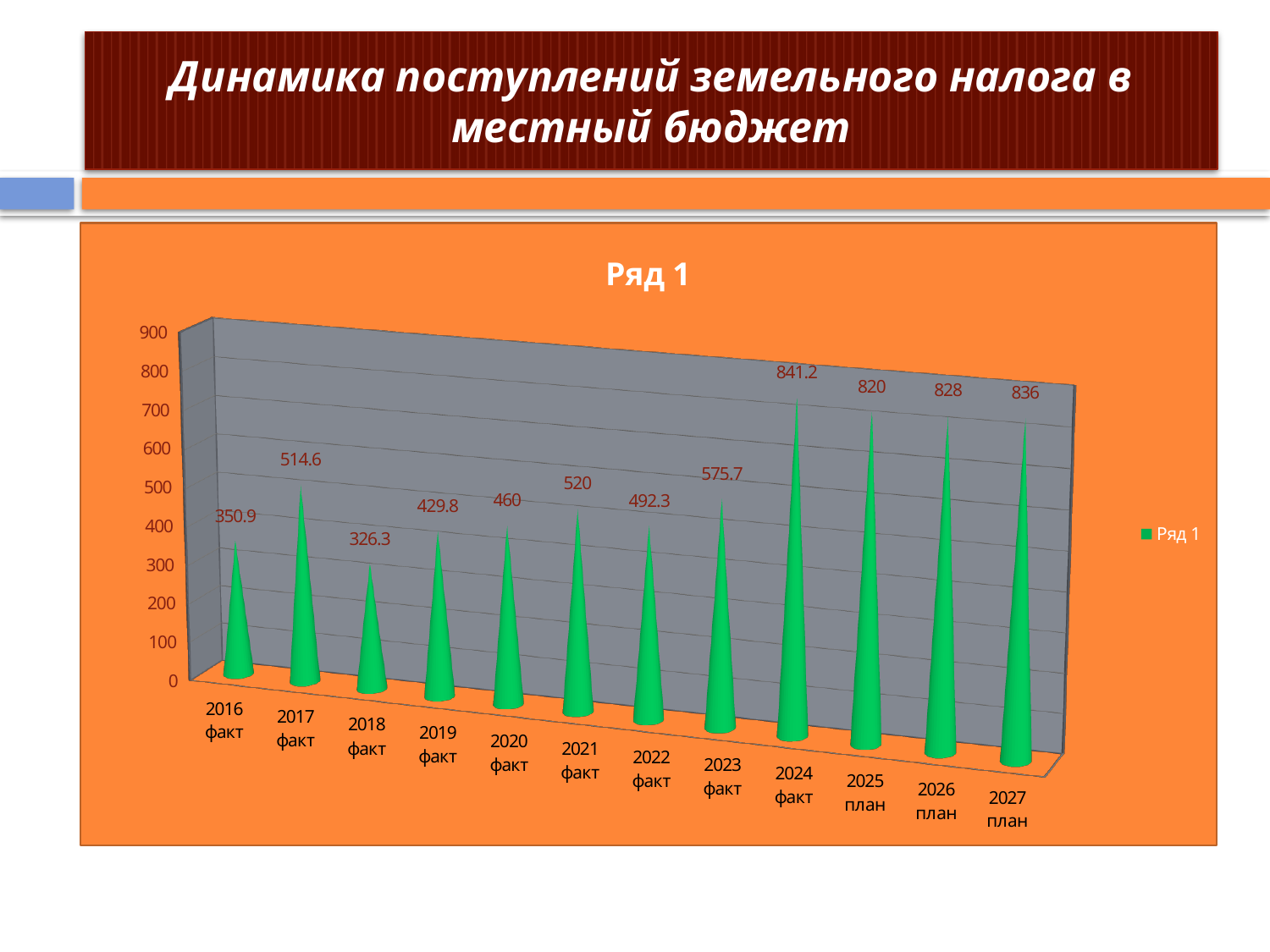
Is the value for 2023 факт greater or less than 500? greater Which is larger, the value for 2021 факт or the value for 2022 факт? 2021 факт What is the value for 2016 факт? 350.9 How many categories are shown on the x axis? 12 Which category has the lowest value? 2018 факт What is the difference between the values for 2017 факт and 2016 факт? 163.7 Which category has the highest value? 2024 факт How many series does the legend list? 1 What is the difference between the values for 2024 факт and 2025 план? 21.2 What is the value for 2027 план? 836 What is the value for 2024 факт? 841.2 What kind of chart is shown on the slide? bar chart